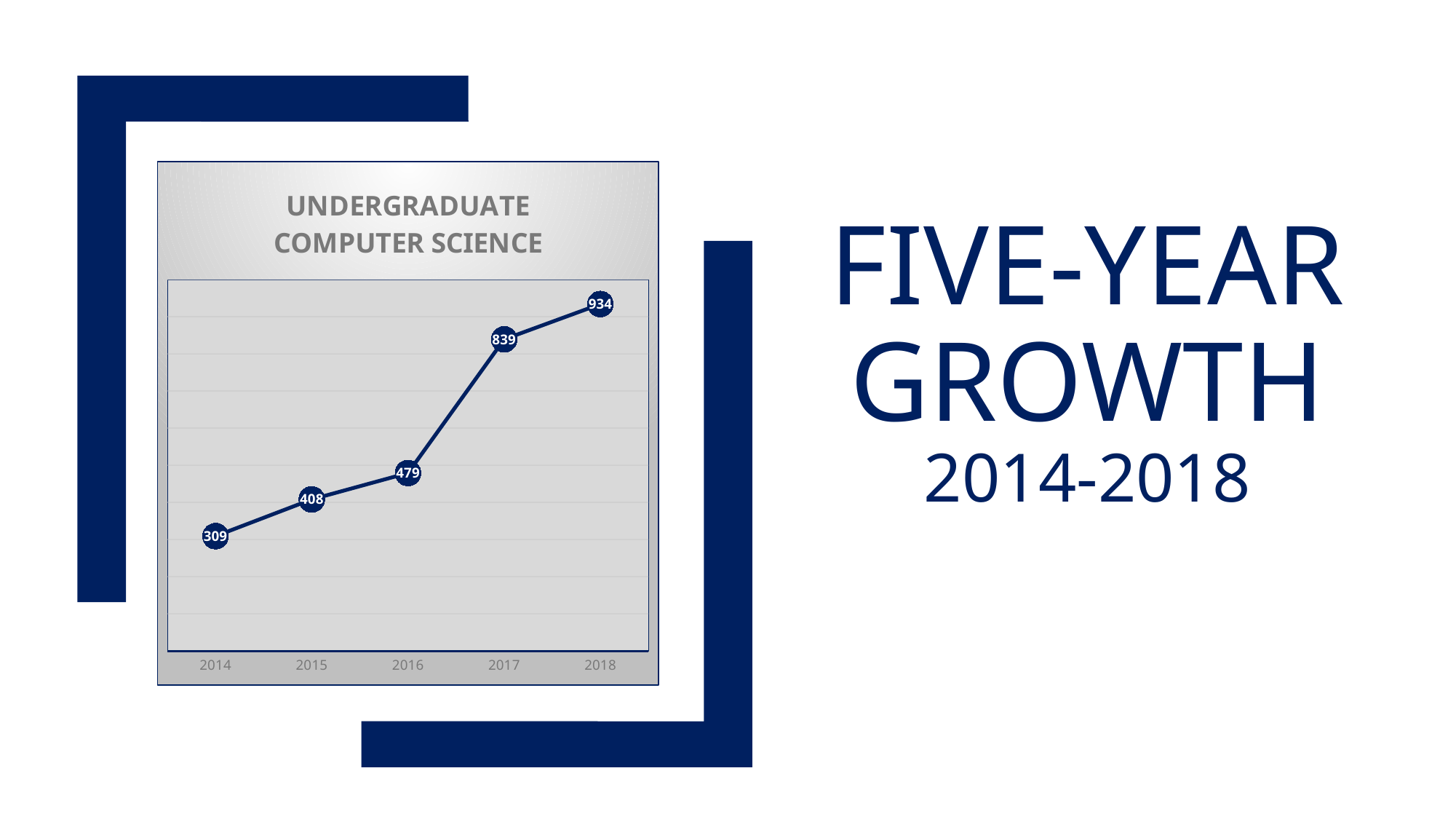
What is the value for 2014? 309 Which year has the highest value? 2018 What is the value for 2018? 934 Do the values rise or fall from 2014 to 2018? rise What is the difference between the values for 2017 and 2016? 360 Which is larger, the value for 2015 or the value for 2017? 2017 Which year has the lowest value? 2014 What is the difference between the values for 2018 and 2014? 625 What kind of chart is shown? line chart What is the value for 2016? 479 What is the title of the chart? UNDERGRADUATE COMPUTER SCIENCE How many years are plotted on the chart? 5